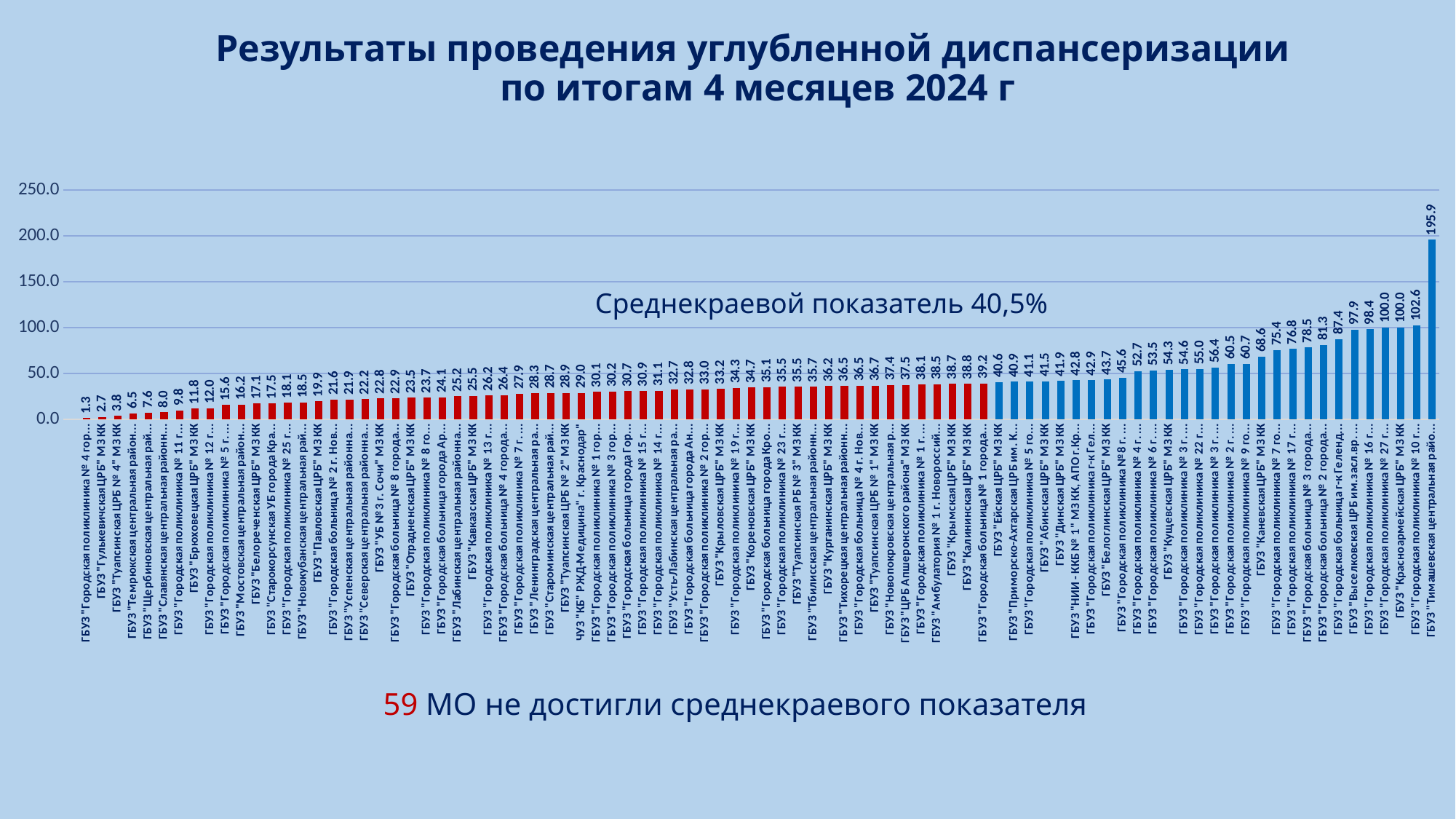
Which has a larger value, ГБУЗ "Крыловская ЦРБ" МЗ КК or ГБУЗ "Курганинская ЦРБ" МЗ КК? ГБУЗ "Курганинская ЦРБ" МЗ КК What is the difference between the values for ГБУЗ "Каневская ЦРБ" МЗ КК and ГБУЗ "Кущевская ЦРБ" МЗ КК? 14.3 What is the lowest value shown in the chart? 1.3 What is the value for ГБУЗ "Красноармейская ЦРБ" МЗ КК? 100.0 What is the highest value shown in the chart? 195.9 What is the regional average (среднекраевой показатель) stated on the chart? 40,5% Do the values rise or fall from left to right along the x axis? rise What is the value for ГБУЗ "Павловская ЦРБ" МЗ КК? 19.9 What is the value for ГБУЗ "Брюховецкая ЦРБ" МЗ КК? 11.8 What is the value for ГБУЗ "Кореновская ЦРБ" МЗ КК? 34.7 What kind of chart is shown on the slide? bar chart What is the value for ГБУЗ "Ейская ЦРБ" МЗ КК? 40.6